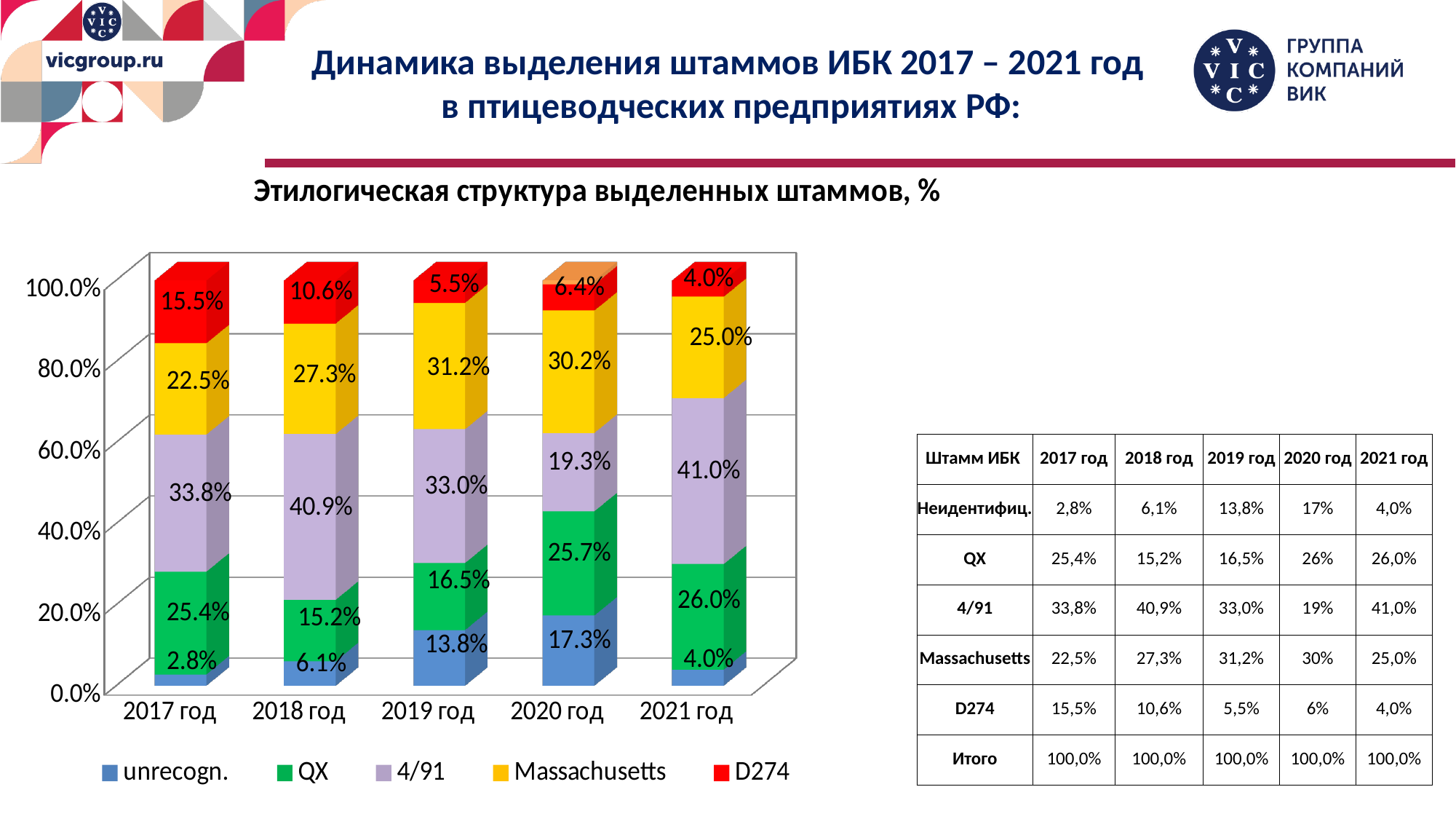
In which year is the D274 share the lowest? 2021 год What colour represents Massachusetts in the chart legend? Yellow What is the value for D274 in 2017 год? 15.5% What is the value for 4/91 in 2018 год? 40.9% What is the difference between the QX value in 2020 год and in 2018 год? 10.5% Does the D274 share rise or fall from 2017 год to 2019 год? Falls How many years are shown on the x axis of the chart? 5 What is the value for unrecogn. in 2019 год? 13.8% How many series does the chart legend list? 5 In which year is the Massachusetts share the highest? 2019 год What kind of chart is shown on the slide? Stacked bar chart Which is larger, the 4/91 value in 2021 год or in 2017 год? 2021 год